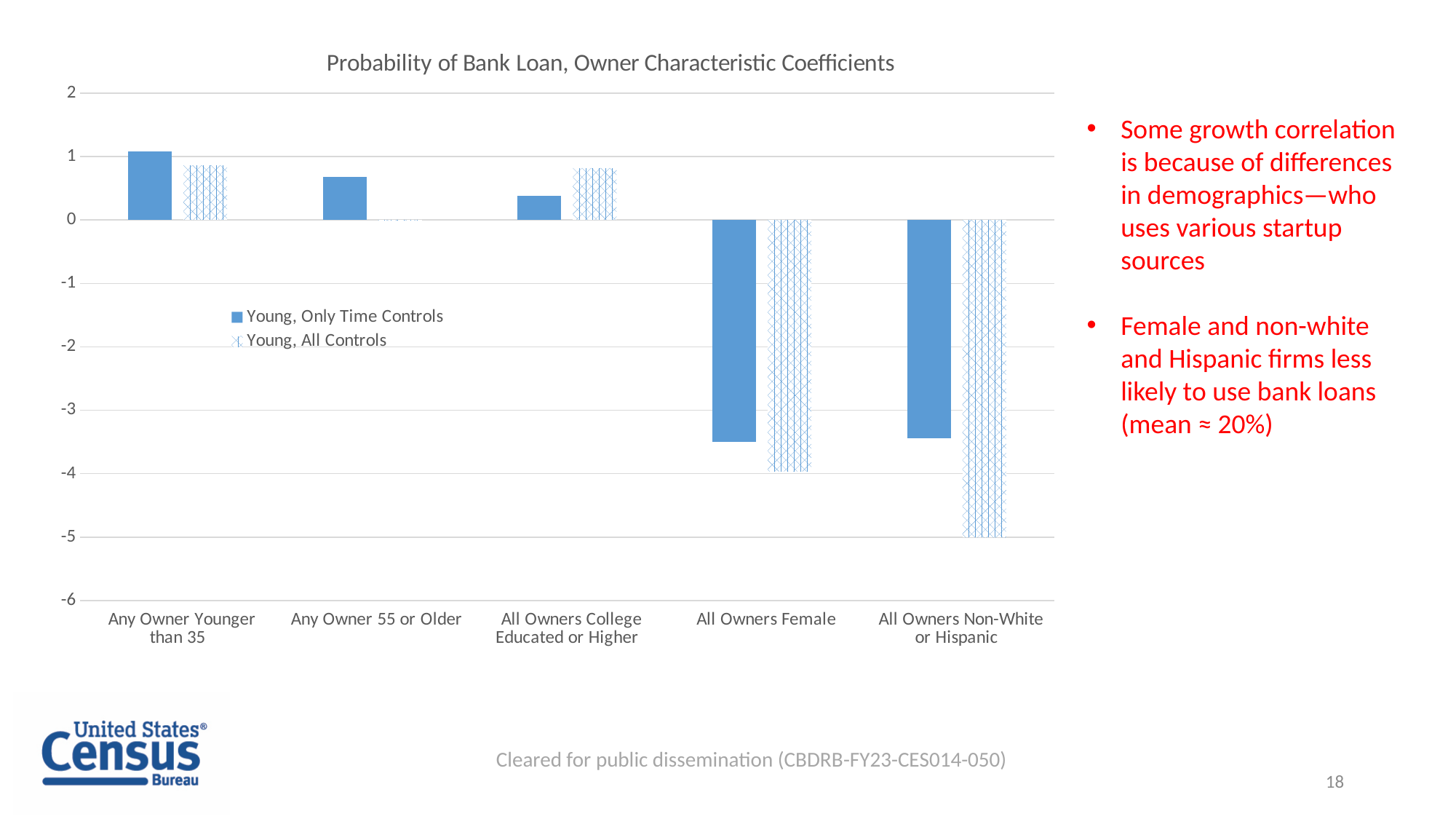
Is the 'Young, All Controls' value for All Owners Non-White or Hispanic greater or less than -4? less Which category has the highest value in the 'Young, Only Time Controls' series? Any Owner Younger than 35 Which category has the lowest value in the 'Young, All Controls' series? All Owners Non-White or Hispanic How many owner-characteristic categories are shown on the x axis? 5 Is the 'Young, Only Time Controls' value for Any Owner 55 or Older greater or less than 1? less What are the two series named in the legend? Young, Only Time Controls; Young, All Controls For All Owners College Educated or Higher, which series has the larger value: 'Young, Only Time Controls' or 'Young, All Controls'? Young, All Controls How many series does the chart's legend list? 2 Is the 'Young, Only Time Controls' value for All Owners Female greater or less than -3? less What is the title of the chart? Probability of Bank Loan, Owner Characteristic Coefficients What kind of chart is shown on the slide? Bar chart How many categories have negative values for the 'Young, Only Time Controls' series? 2